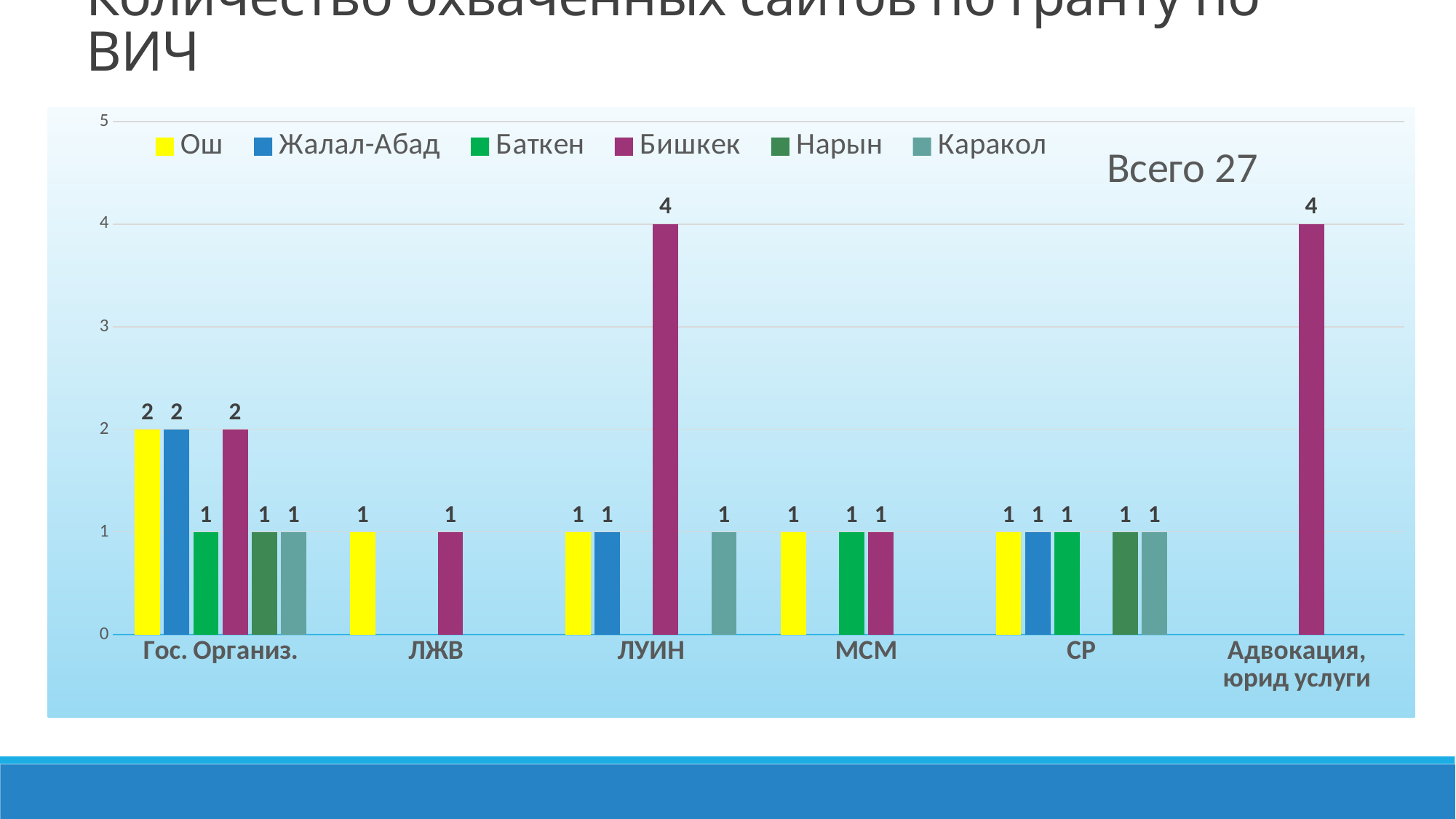
What is the value for Бишкек in the ЛУИН category? 4 What is the value for Ош in the Гос. Организ. category? 2 What is the value for Каракол in the СР category? 1 How many categories are shown on the x axis? 6 What is the difference between the Бишкек value in ЛУИН and the Ош value in ЛУИН? 3 How many series does the legend list? 6 What type of chart is shown on the slide? bar chart Which series is the only one with a bar in the Адвокация, юрид услуги category? Бишкек What is the value for Бишкек in the Адвокация, юрид услуги category? 4 Which is larger: the Жалал-Абад value in Гос. Организ. or the Жалал-Абад value in СР? Гос. Организ. What total is stated in the text inside the chart area? Всего 27 Which series has the highest value in the ЛУИН category? Бишкек